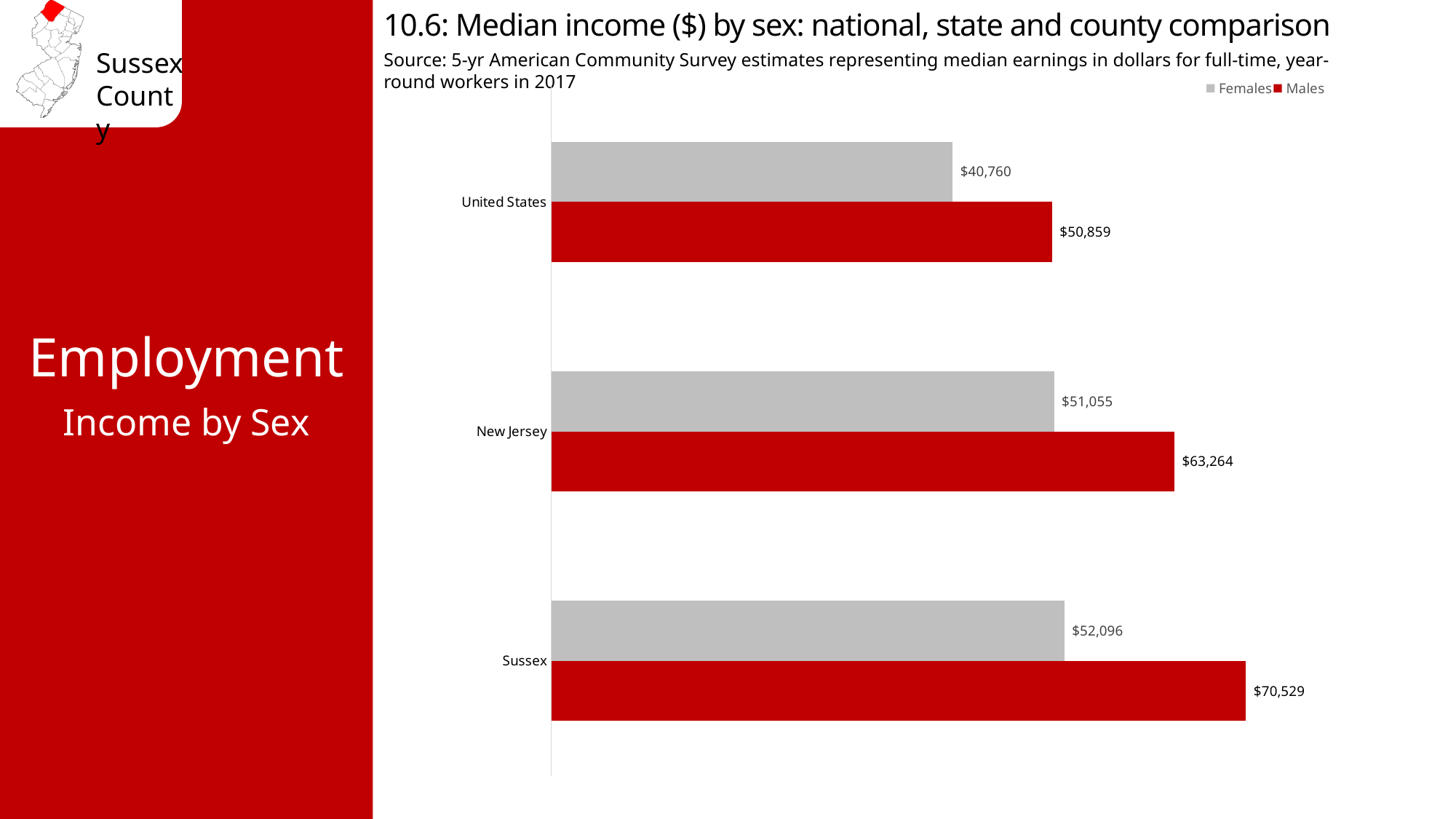
How many series does the legend list? 2 What kind of chart is shown on the slide? Bar chart What is the median income for females in Sussex? $52,096 What is the median income for females in the United States? $40,760 Which is larger: female median income in New Jersey or male median income in the United States? Female median income in New Jersey What is the difference between male median income in New Jersey and in the United States? $12,405 How many categories are shown on the chart? 3 What is the median income for males in Sussex? $70,529 What is the difference between male and female median income in Sussex? $18,433 What is the median income for males in New Jersey? $63,264 Which category has the highest median income for males? Sussex Which category has the lowest median income for females? United States